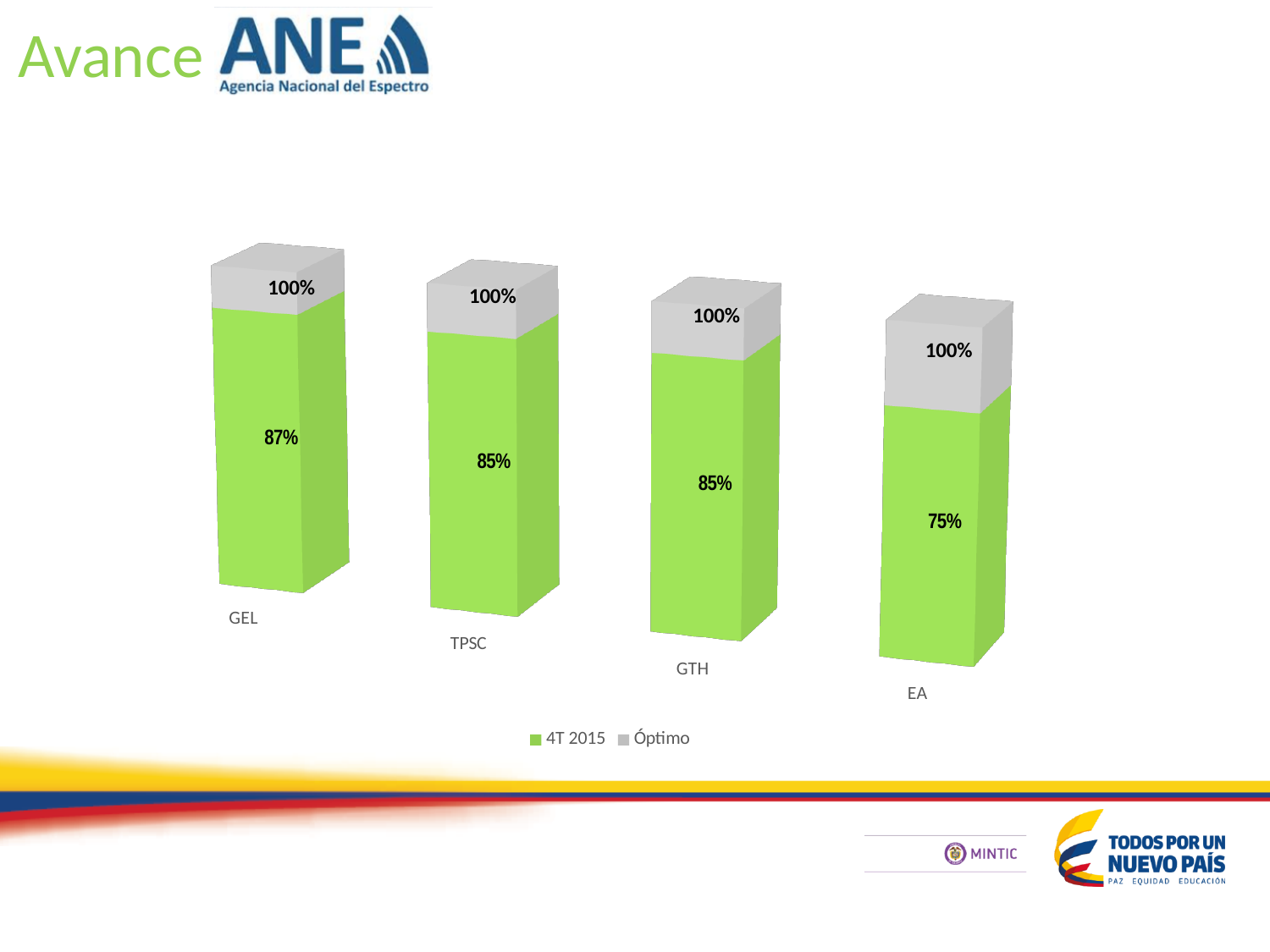
Which category has the lowest 4T 2015 value? EA How many categories are shown on the x axis? 4 Which category has the highest 4T 2015 value? GEL What is the difference between the 4T 2015 values for GEL and EA? 12% How many series does the legend list? 2 What is the 4T 2015 value for GEL? 87% What is the difference between the Óptimo value and the 4T 2015 value for GTH? 15% What is the Óptimo value for GTH? 100% What kind of chart is shown on the slide? Bar chart Which is larger, the 4T 2015 value for GEL or for TPSC? GEL What is the 4T 2015 value for EA? 75% What is the 4T 2015 value for TPSC? 85%